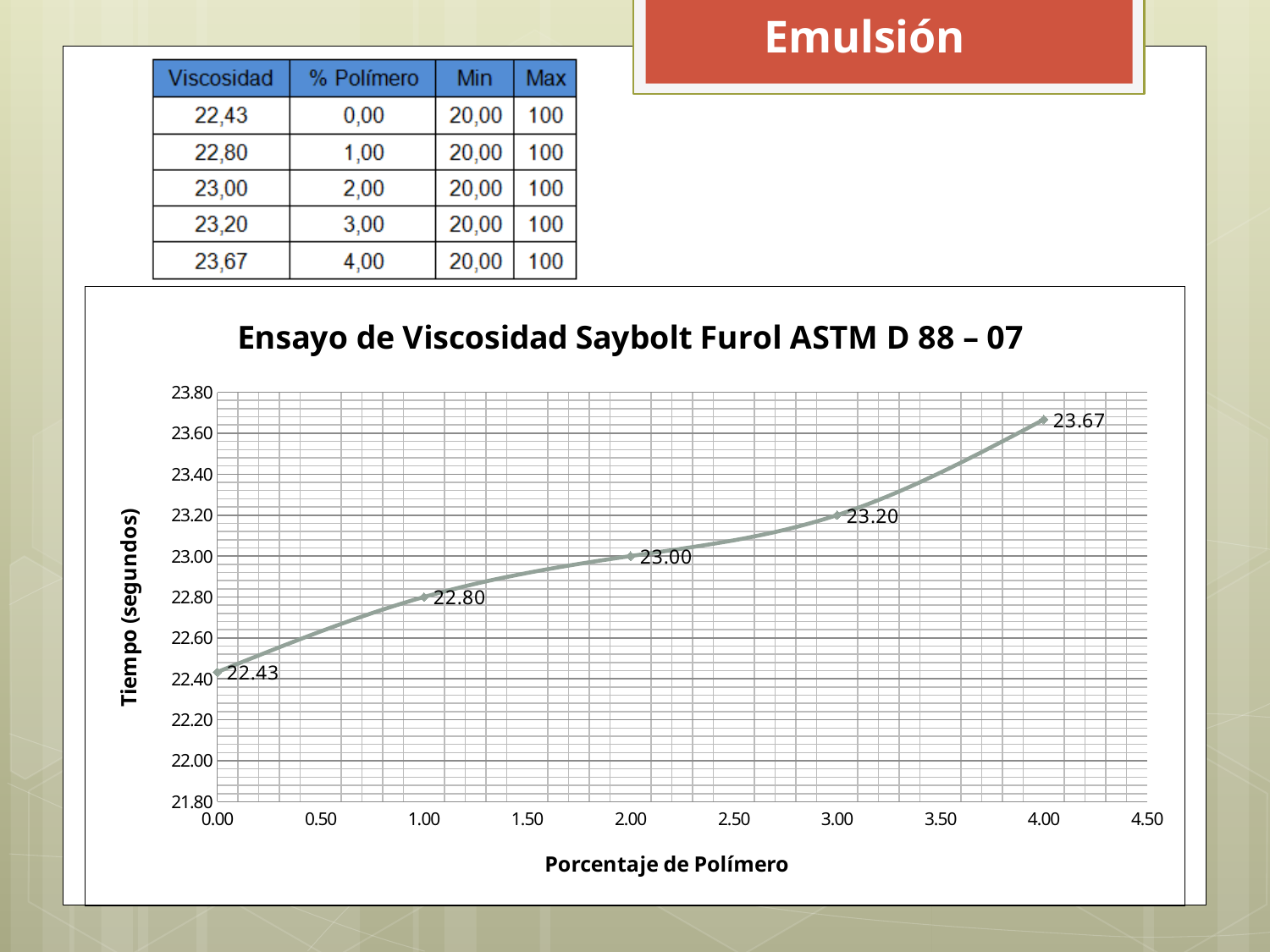
What kind of chart is shown on the slide? line chart Which has a larger Tiempo (segundos): 1.00 or 3.00 Porcentaje de Polímero? 3.00 What is the difference in Tiempo (segundos) between 3.00 and 1.00 Porcentaje de Polímero? 0.40 At which Porcentaje de Polímero is Tiempo (segundos) highest? 4.00 What is the difference in Tiempo (segundos) between 4.00 and 0.00 Porcentaje de Polímero? 1.24 What is the value of Tiempo (segundos) at 0.00 Porcentaje de Polímero? 22.43 What is the value of Tiempo (segundos) at 4.00 Porcentaje de Polímero? 23.67 How many data points are plotted on the chart? 5 What is the title of the chart? Ensayo de Viscosidad Saybolt Furol ASTM D 88 – 07 What is the value of Tiempo (segundos) at 2.00 Porcentaje de Polímero? 23.00 Does Tiempo (segundos) rise or fall as Porcentaje de Polímero increases? rise At which Porcentaje de Polímero is Tiempo (segundos) lowest? 0.00